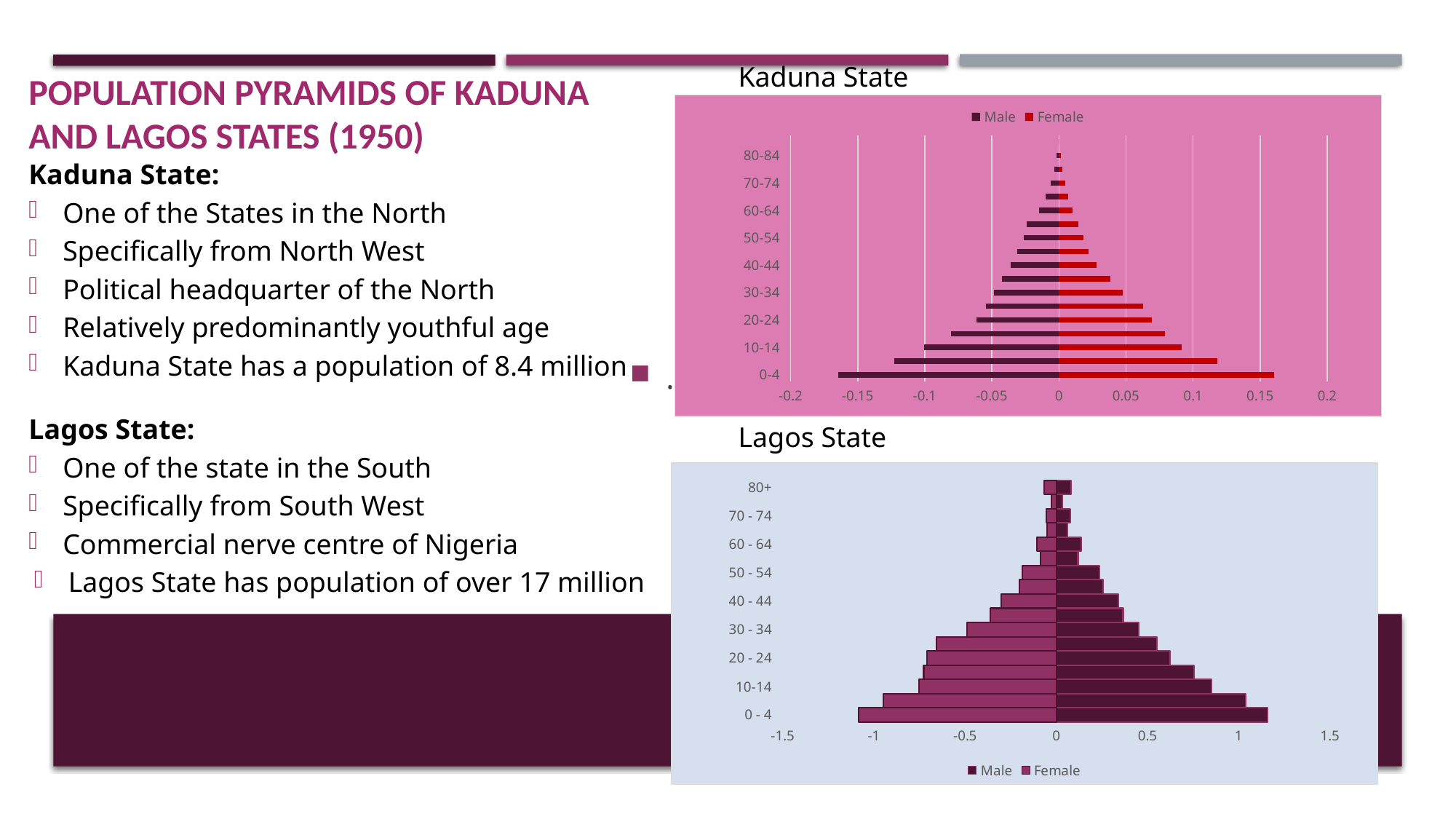
In the Kaduna State chart, which is larger, the Female bar for 0-4 or the Female bar for 40-44? 0-4 What are the two series named in the legend of the Lagos State chart? Male and Female In the Lagos State chart, do the bar lengths rise or fall as the age groups go from 0 - 4 up to 80+? fall In the Kaduna State chart, is the Female value for the 10-14 age group greater or less than 0.1? less In the Kaduna State chart, is the Female value for the 0-4 age group greater or less than 0.15? greater In the Lagos State chart, is the Male value for the 10-14 age group greater or less than 1? less What kind of chart is the Kaduna State chart? bar chart In the Lagos State chart, which age group has the longest Male bar? 0 - 4 What is the title shown above the lower chart on the slide? Lagos State In the Kaduna State chart, which age group has the longest Female bar? 0-4 How many series does the legend of the Kaduna State chart list? 2